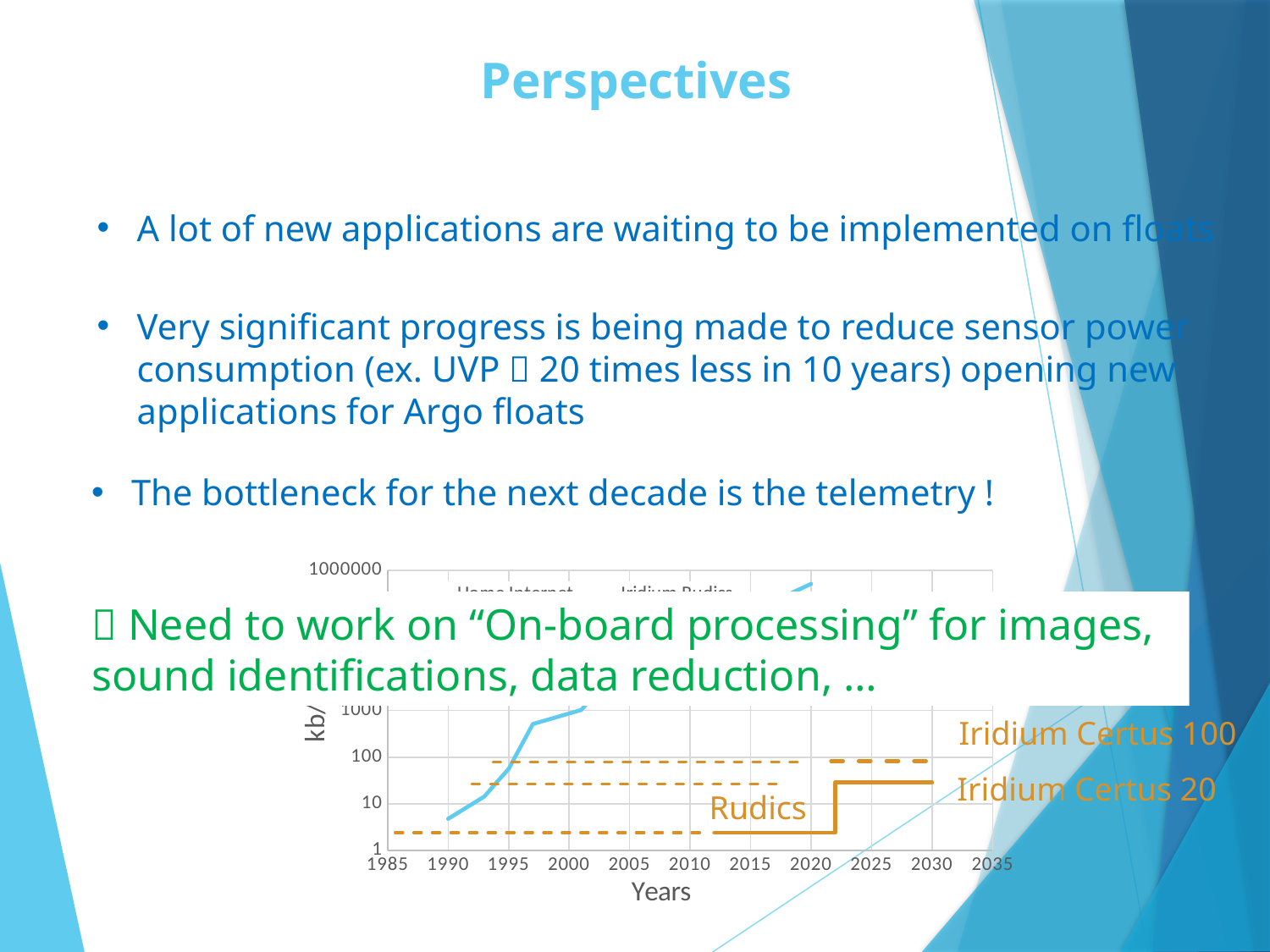
Is the value of the solid orange Iridium Certus 20 line after 2022 greater or less than 100? less What is the last year labelled on the x axis of the chart? 2035 Which is larger around 2025: the value of the Iridium Certus 100 dashed line or the Iridium Certus 20 solid line? Iridium Certus 100 Is the value of the blue line at 2000 greater or less than 100? greater What kind of chart is shown at the bottom of the slide? line chart What is the title of the x axis of the chart? Years Is the value of the solid orange Iridium Certus 20 line after 2022 greater or less than 10? greater Does the blue line in the chart rise or fall as the years increase from 1990 to 2000? rise How many year tick labels are shown on the x axis of the chart? 11 What is the highest value labelled on the y axis of the chart? 1000000 What is the first year labelled on the x axis of the chart? 1985